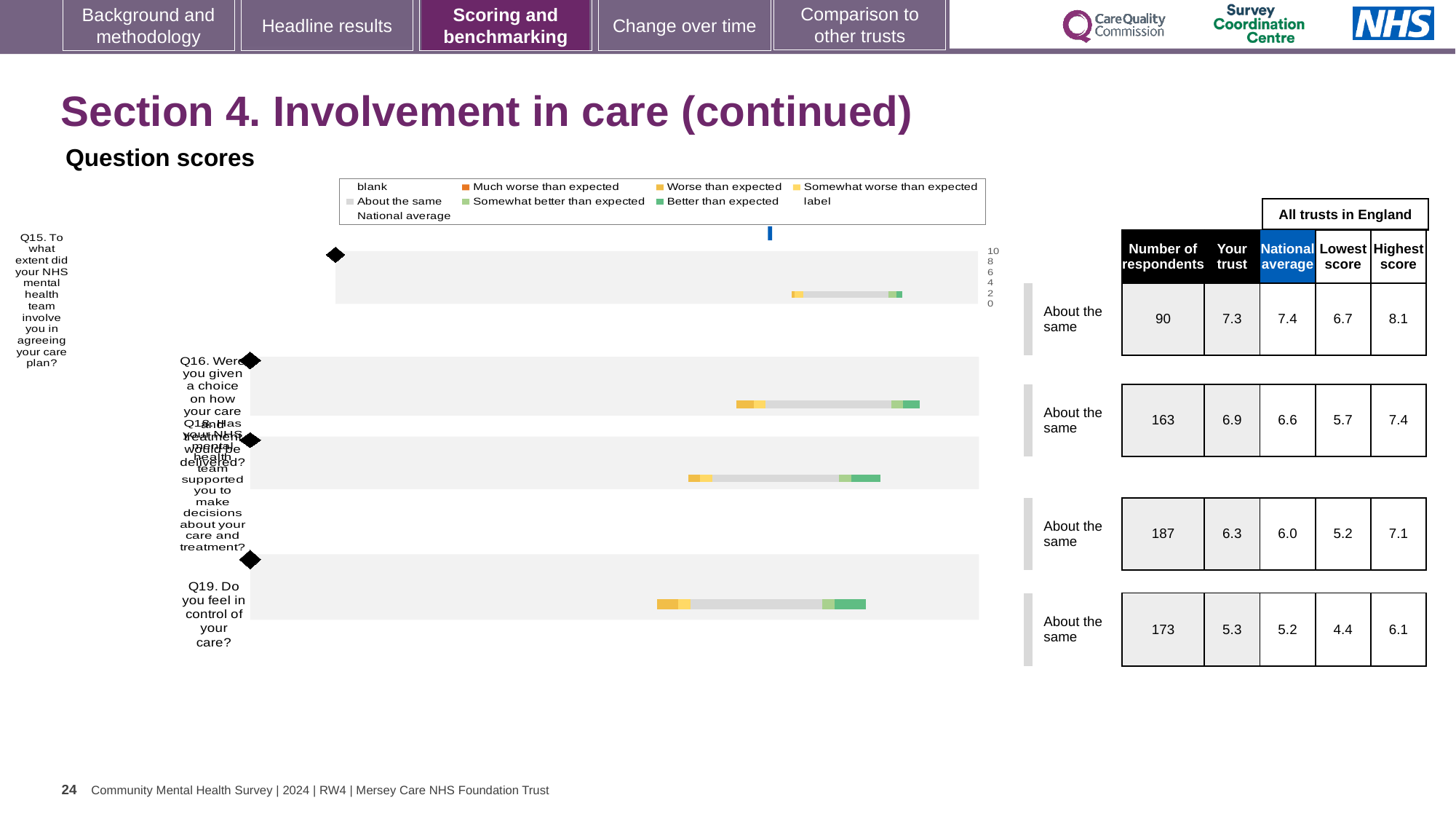
What is the highest score among all trusts in England for Q19 (feeling in control of your care)? 6.1 What benchmark category is shown for each of the four questions on this slide? About the same Which question has the highest 'Your trust' score? Q15 What is the national average score for Q16 (given a choice on how care and treatment would be delivered)? 6.6 What kind of chart is used to show the question scores on this slide? bar chart For Q18, which is larger: the 'Your trust' score or the national average? Your trust What is the 'Your trust' score for Q15 (involving you in agreeing your care plan)? 7.3 How many questions (categories) are plotted in the question scores chart? 4 How many respondents answered Q18 (supported you to make decisions about your care and treatment)? 187 Which question has the fewest respondents? Q15 What is the difference between the 'Your trust' score and the national average for Q16? 0.3 Which question has the lowest 'Your trust' score? Q19